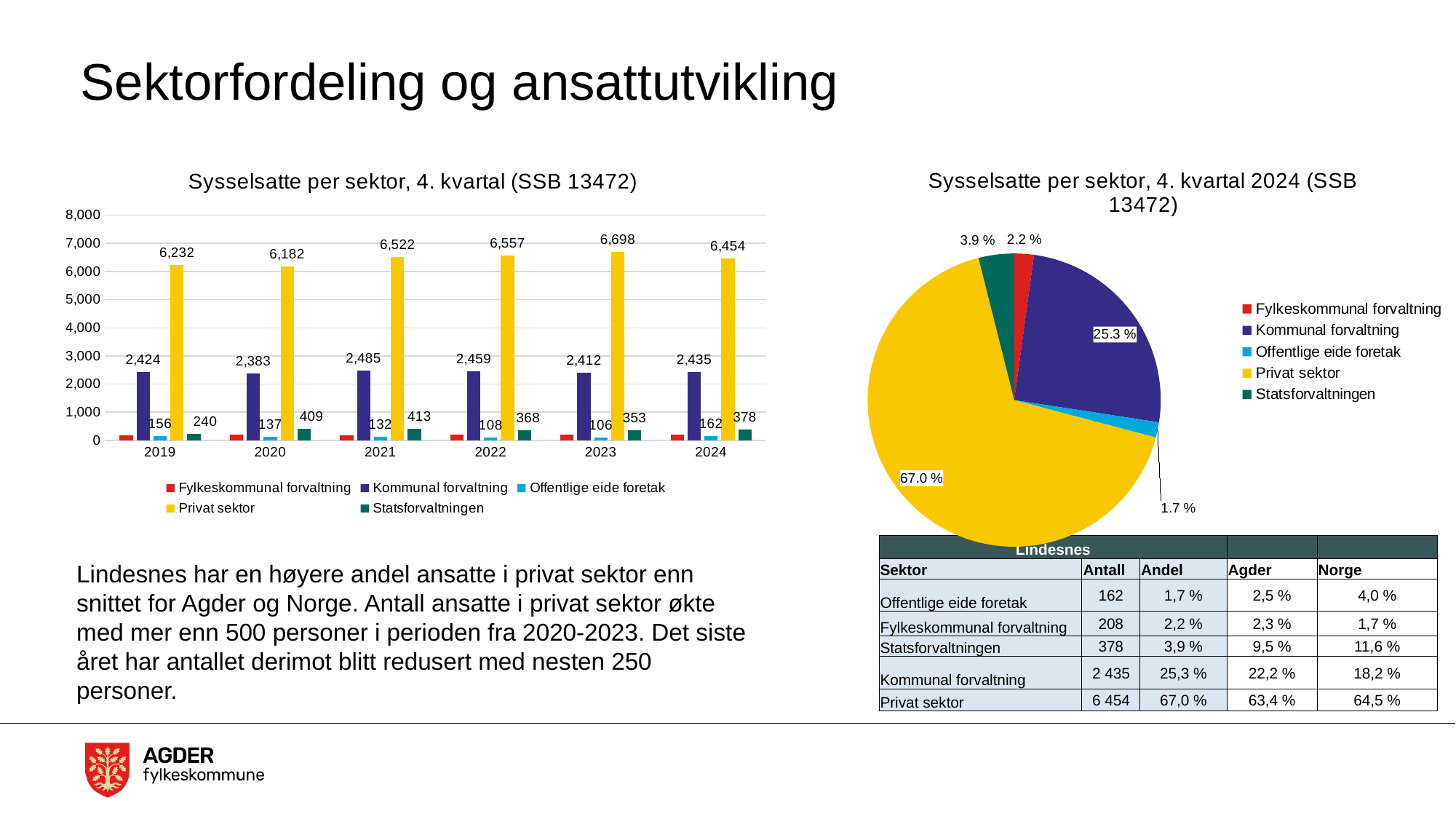
What kind of chart is 'Sysselsatte per sektor, 4. kvartal (SSB 13472)' on the left of the slide? Bar chart In the pie chart 'Sysselsatte per sektor, 4. kvartal 2024 (SSB 13472)', what share does Privat sektor have? 67.0 % In the bar chart 'Sysselsatte per sektor, 4. kvartal (SSB 13472)', what is the difference between Privat sektor in 2023 and in 2024? 244 In the bar chart 'Sysselsatte per sektor, 4. kvartal (SSB 13472)', in which year is Privat sektor highest? 2023 In the bar chart 'Sysselsatte per sektor, 4. kvartal (SSB 13472)', how many years are shown on the x axis? 6 In the bar chart 'Sysselsatte per sektor, 4. kvartal (SSB 13472)', in which year is Offentlige eide foretak lowest? 2023 In the pie chart 'Sysselsatte per sektor, 4. kvartal 2024 (SSB 13472)', which sector has the smallest slice? Offentlige eide foretak In the bar chart 'Sysselsatte per sektor, 4. kvartal (SSB 13472)', what is the value for Kommunal forvaltning in 2021? 2,485 In the bar chart 'Sysselsatte per sektor, 4. kvartal (SSB 13472)', is Statsforvaltningen larger in 2020 or in 2022? 2020 In the bar chart 'Sysselsatte per sektor, 4. kvartal (SSB 13472)', what is the value for Privat sektor in 2023? 6,698 In the bar chart 'Sysselsatte per sektor, 4. kvartal (SSB 13472)', what is the value for Statsforvaltningen in 2019? 240 In the bar chart 'Sysselsatte per sektor, 4. kvartal (SSB 13472)', how many series does the legend list? 5